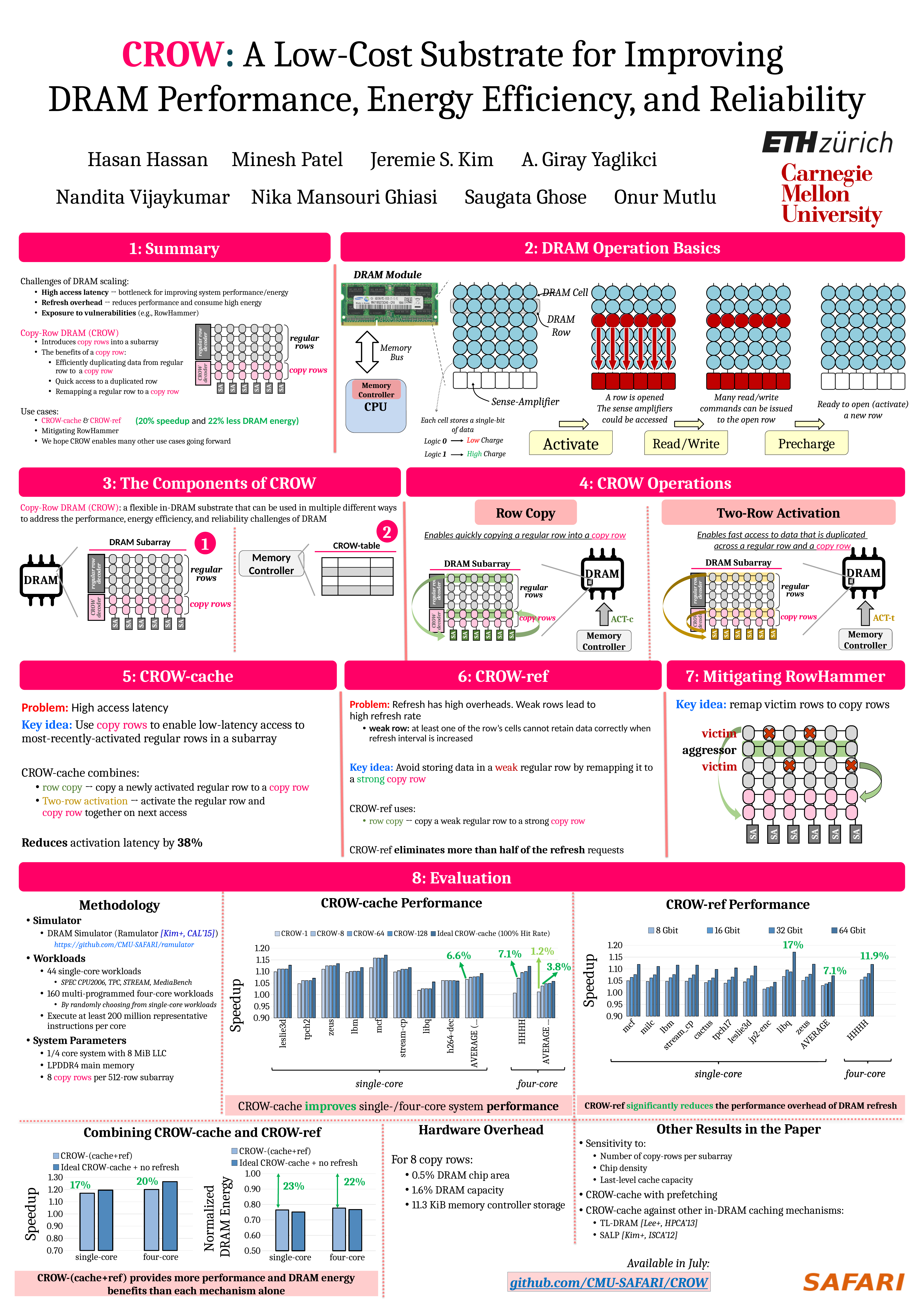
In the Combining CROW-cache and CROW-ref Normalized DRAM Energy chart, what percentage reduction is annotated for single-core? 23% In the CROW-cache Performance chart, which single-core workload has the highest speedup? mcf How many series does the legend of the CROW-ref Performance chart list? 4 What are the two legend entries of the Combining CROW-cache and CROW-ref charts? CROW-(cache+ref) and Ideal CROW-cache + no refresh In the CROW-ref Performance chart, which workload has the highest speedup bar? libq In the CROW-ref Performance chart, is the 64 Gbit speedup for libq greater or less than 1.15? greater How many workload categories are shown on the x axis of the CROW-ref Performance chart? 12 How many series does the legend of the CROW-cache Performance chart list? 5 In the CROW-cache Performance chart, which single-core workload has the lowest speedup? libq What kind of chart is the CROW-cache Performance chart? bar chart In the Combining CROW-cache and CROW-ref Speedup chart, what percentage improvement is annotated for four-core? 20%